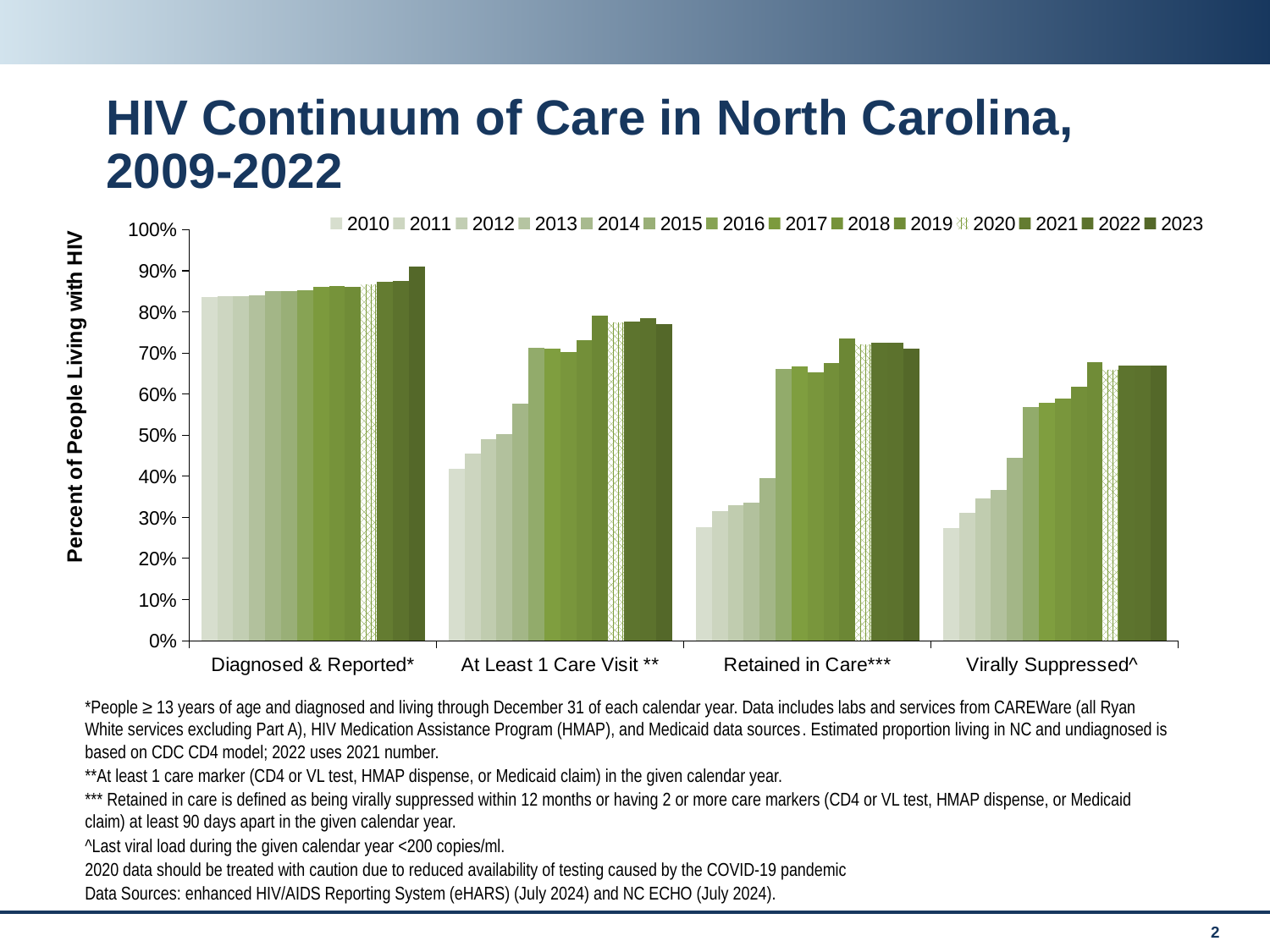
Which legend series is drawn with a hatched pattern instead of a solid fill? 2020 Is the 2010 value for Diagnosed & Reported greater or less than 80%? greater Is the 2023 value for Virally Suppressed greater or less than 60%? greater Which category has the highest 2023 bar? Diagnosed & Reported How many series does the chart's legend list? 14 How many categories are shown along the x axis of the chart? 4 Which is larger: the 2010 value for Diagnosed & Reported or the 2010 value for Virally Suppressed? Diagnosed & Reported Is the 2010 value for Retained in Care greater or less than 30%? less What kind of chart is shown on the slide? Bar chart Which category has the lowest 2023 bar? Virally Suppressed